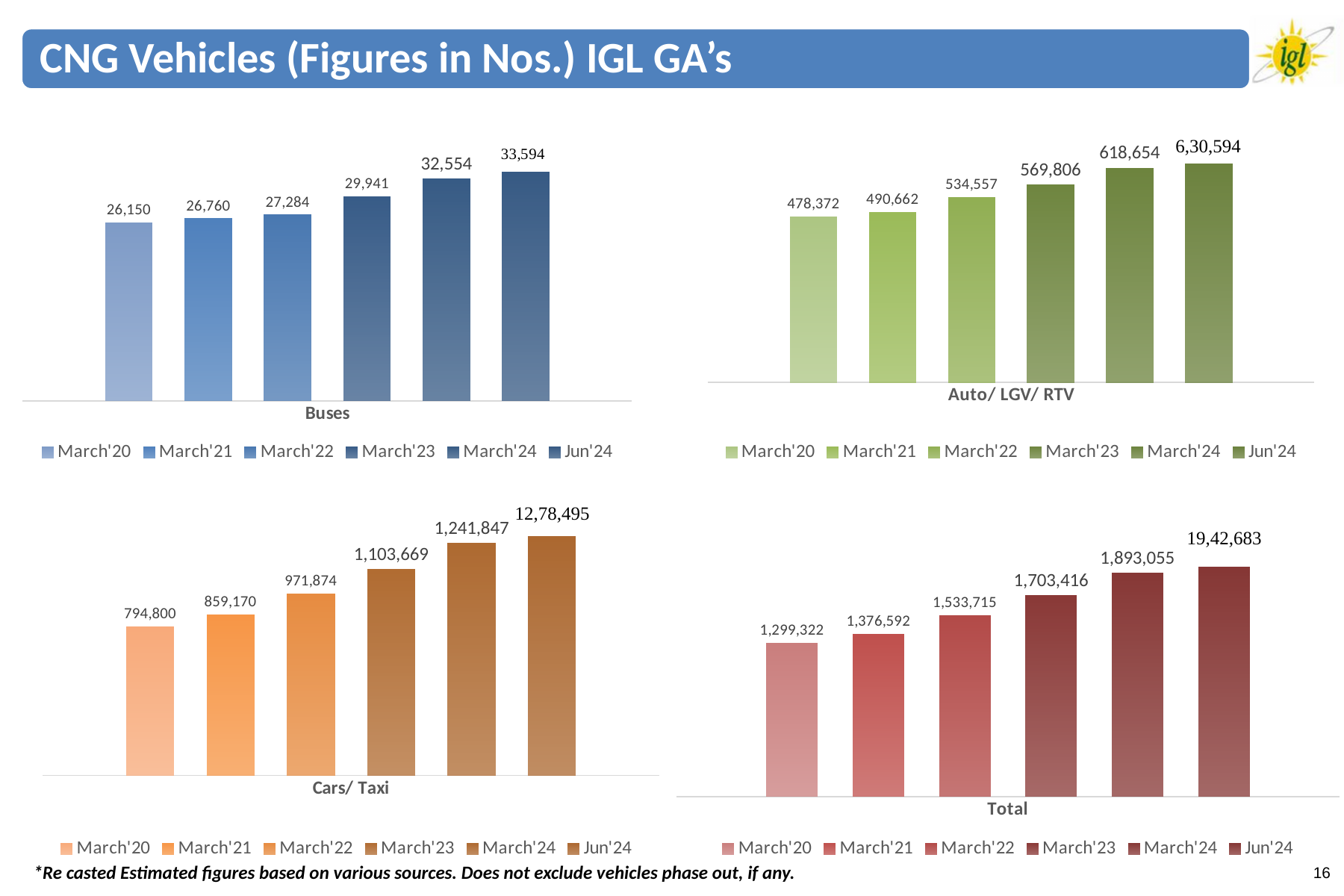
In the Buses chart, what is the value for March'23? 29,941 In the Auto/ LGV/ RTV chart, what is the value for March'22? 534,557 In the Total chart, which period has the lowest value? March'20 What type of chart is the Cars/ Taxi chart? Bar chart In the Buses chart, which period has the highest value? Jun'24 In the Total chart, do the values rise or fall from March'20 to Jun'24? Rise In the Cars/ Taxi chart, what is the value for March'20? 794,800 In the Buses chart, what is the difference between the Jun'24 and March'24 values? 1,040 In the Total chart, what is the value for March'24? 1,893,055 In the Cars/ Taxi chart, which is larger, the value for March'22 or March'21? March'22 How many bars are shown in the Auto/ LGV/ RTV chart? 6 In the Total chart, what is the difference between the March'24 and March'23 values? 189,639